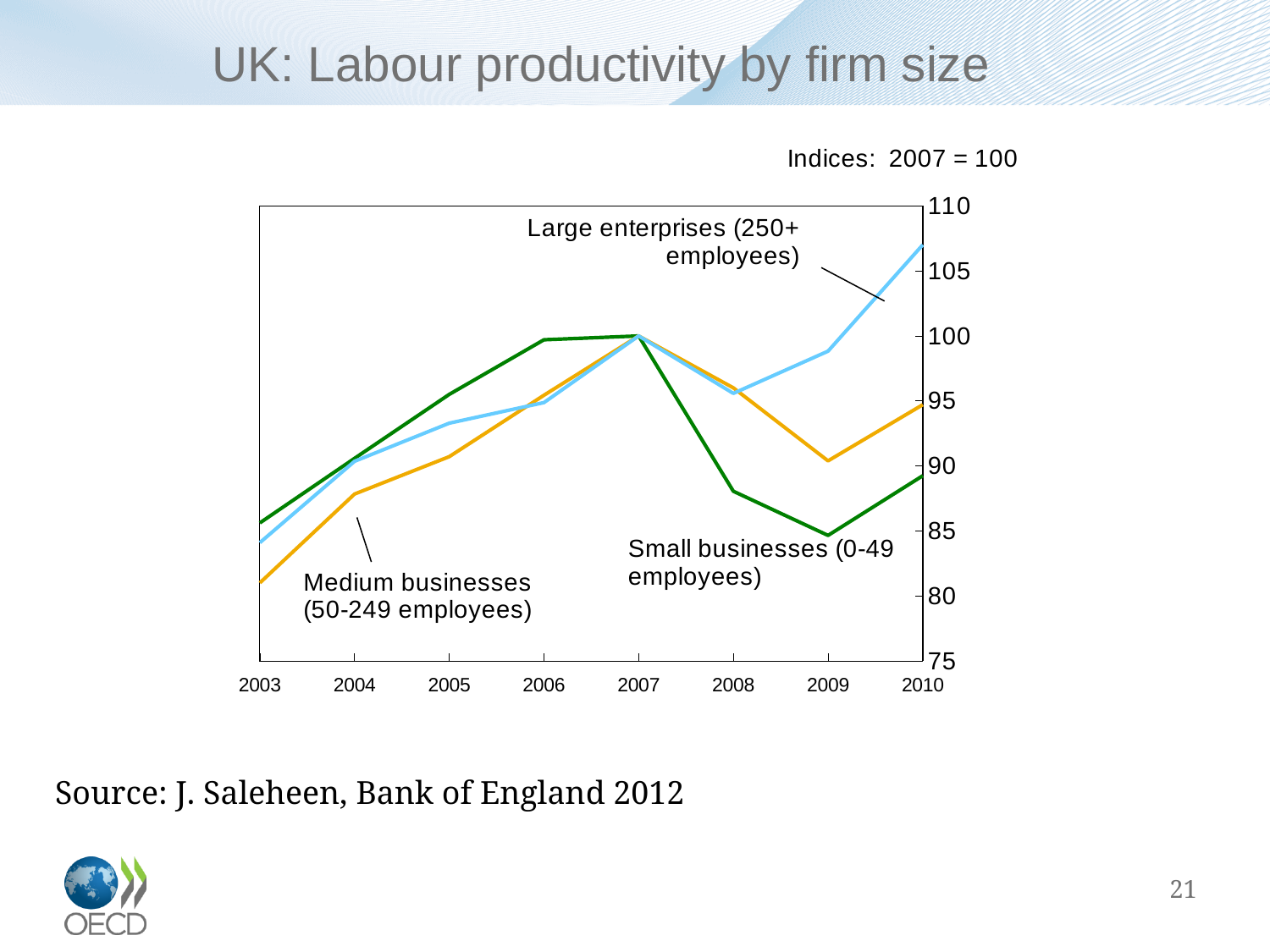
Which base year is the index set to 100? 2007 Is the value for Medium businesses (50-249 employees) in 2003 greater or less than 85? less Which firm size group has the lowest labour productivity index in 2009? Small businesses (0-49 employees) How many series (firm size groups) are plotted on the chart? 3 Which firm size group has the highest labour productivity index in 2010? Large enterprises (250+ employees) In 2009, which is higher: Medium businesses (50-249 employees) or Small businesses (0-49 employees)? Medium businesses (50-249 employees) Is the value for Small businesses (0-49 employees) in 2008 greater or less than 90? less What is the index value for all three firm size groups in 2007? 100 Is the value for Large enterprises (250+ employees) in 2010 greater or less than 105? greater How many years are shown along the x axis of the chart? 8 Does the index for Small businesses (0-49 employees) rise or fall between 2007 and 2009? fall What kind of chart is shown on the slide? line chart